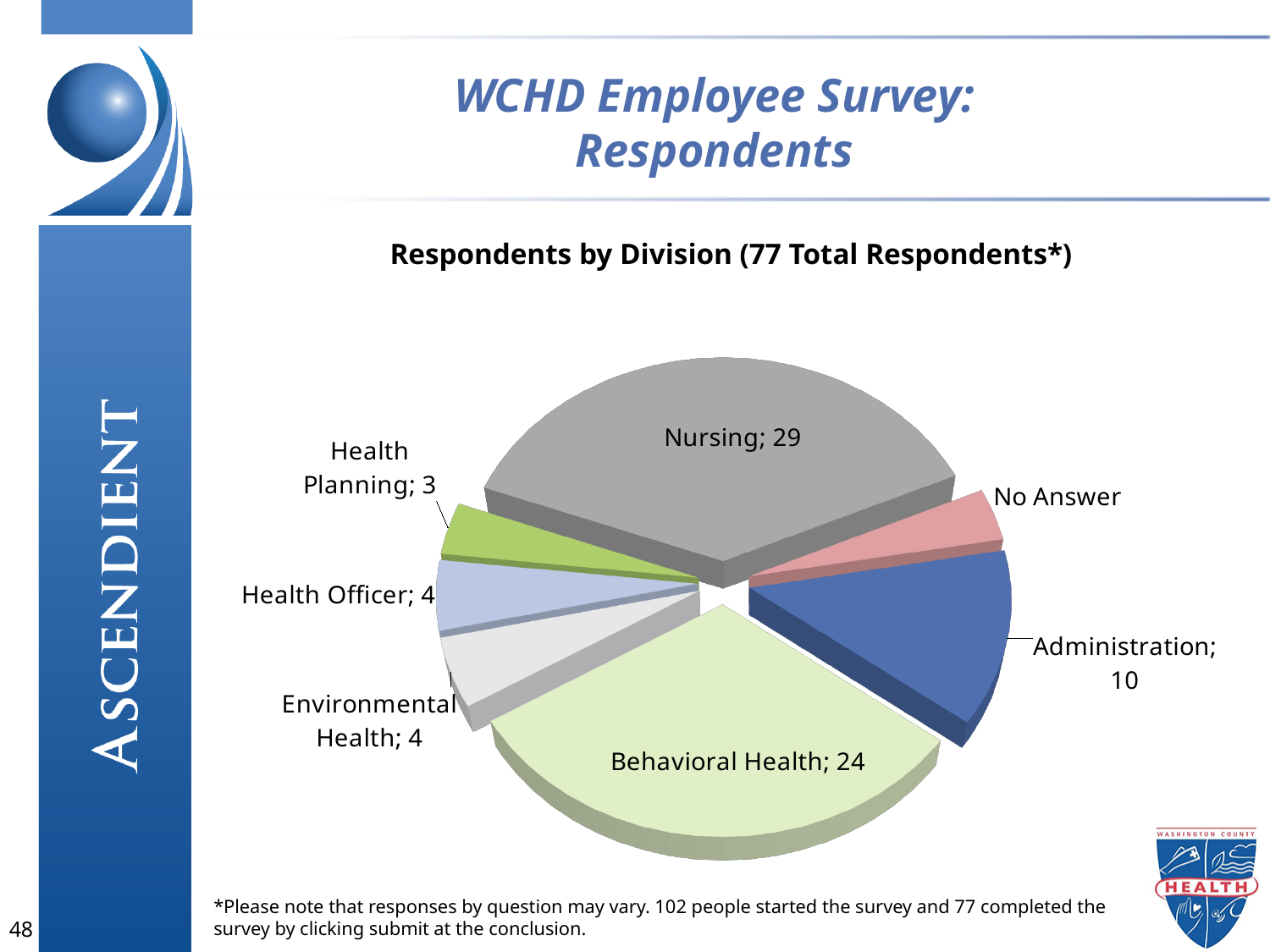
What is the difference between the Administration and Health Planning respondent counts? 7 How many respondents are from Behavioral Health? 24 What is the difference between the Nursing and Behavioral Health respondent counts? 5 How many respondents are from Environmental Health? 4 How many respondents are from Health Planning? 3 Which has more respondents, Administration or Health Officer? Administration What is the title of the chart? Respondents by Division (77 Total Respondents*) What type of chart is shown on the slide? Pie chart How many respondents are from the Nursing division? 29 Which division has the largest number of respondents? Nursing How many slices does the pie chart have? 7 How many respondents are from Administration? 10